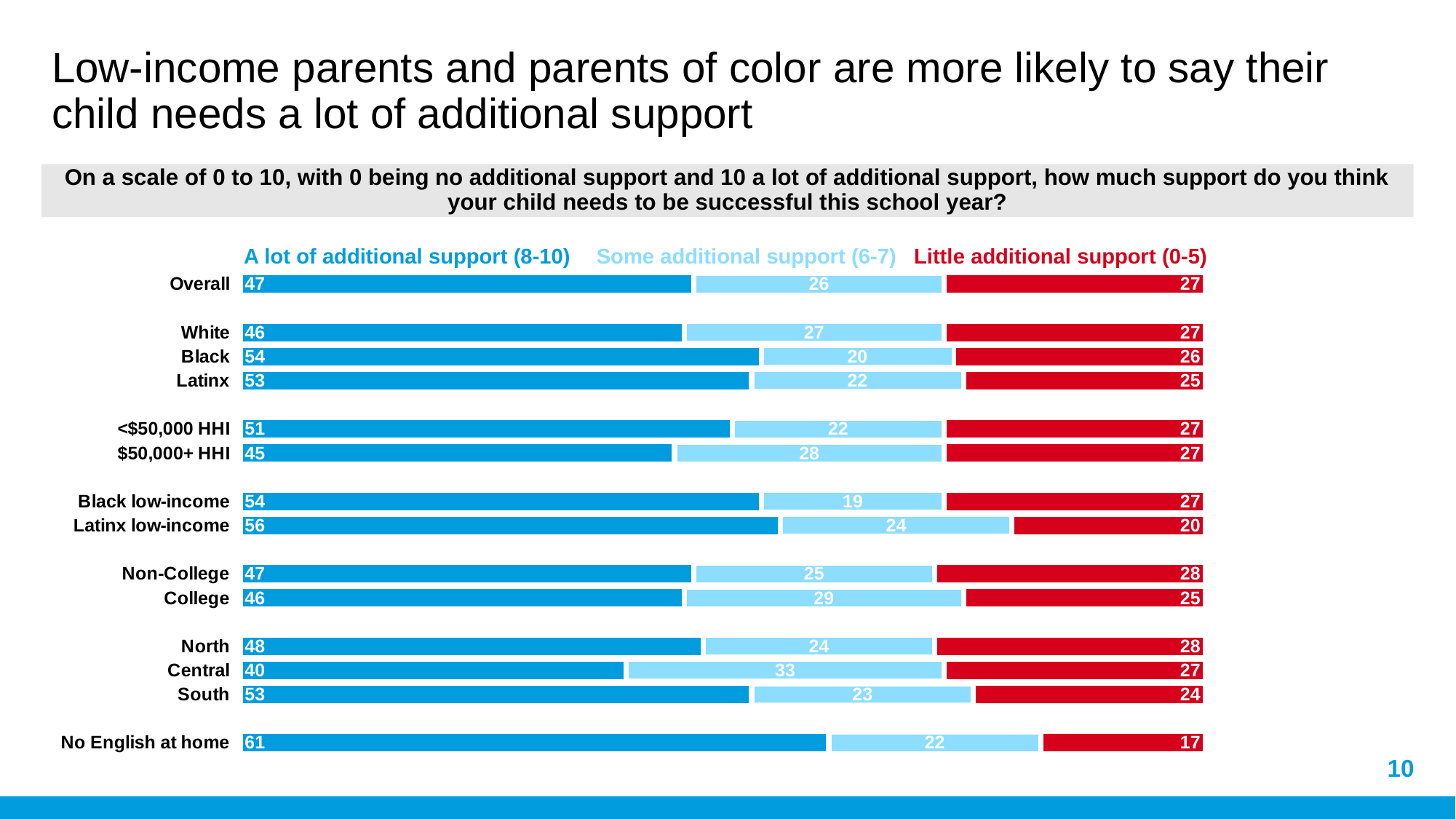
How many series does the legend list? 3 What is the Little additional support (0-5) value for No English at home? 17 Which category has the highest value for A lot of additional support (8-10)? No English at home What is the difference between the A lot of additional support (8-10) values for No English at home and Overall? 14 What percentage of Overall parents say their child needs a lot of additional support (8-10)? 47 Which has a larger A lot of additional support (8-10) value, Black or White? Black What is the total of the stacked bar for Latinx low-income? 100 How many categories are shown on the chart? 14 Which category has the highest value for Some additional support (6-7)? Central What kind of chart is shown on the slide? Stacked bar chart Which category has the lowest value for A lot of additional support (8-10)? Central What is the value for Central in the Some additional support (6-7) series? 33